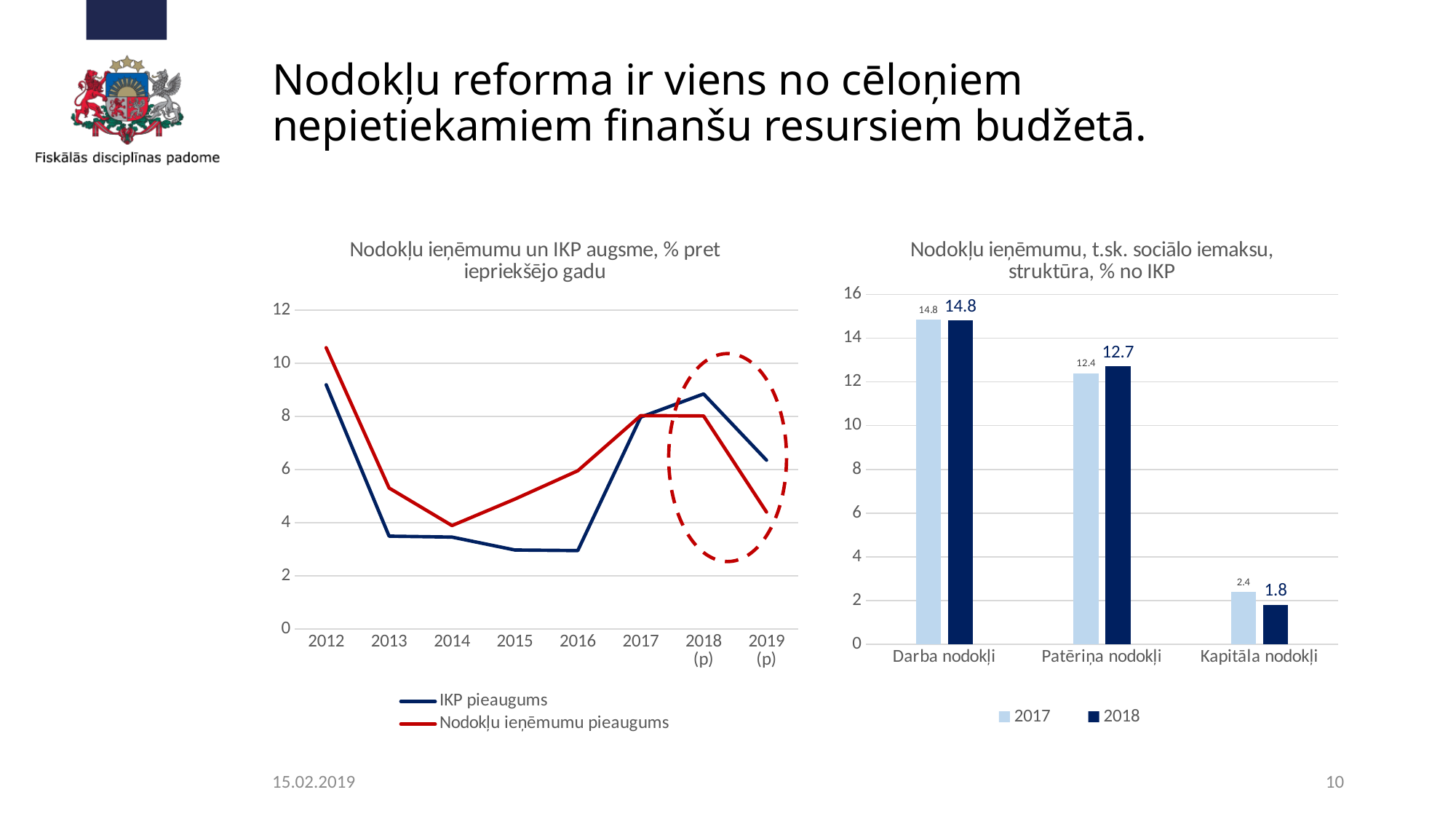
In the right chart, which category has the highest 2017 value? Darba nodokļi In the right chart, what is the 2018 value for Darba nodokļi? 14.8 In the right chart, is the 2017 or the 2018 value larger for Kapitāla nodokļi? 2017 In the left chart, is the value of IKP pieaugums in 2015 greater or less than 4? less In the right chart, what is the 2017 value for Kapitāla nodokļi? 2.4 In the right chart (Nodokļu ieņēmumu, t.sk. sociālo iemaksu, struktūra, % no IKP), what is the 2018 value for Patēriņa nodokļi? 12.7 What kind of chart is the left chart (Nodokļu ieņēmumu un IKP augsme, % pret iepriekšējo gadu)? Line chart In the right chart, how many series does the legend list? 2 In the right chart, which category has the lowest 2018 value? Kapitāla nodokļi In the left chart, how many years are shown on the x axis? 8 In the right chart, what is the difference between the 2018 and 2017 values for Patēriņa nodokļi? 0.3 In the left chart, is the value of Nodokļu ieņēmumu pieaugums in 2012 greater or less than 10? greater